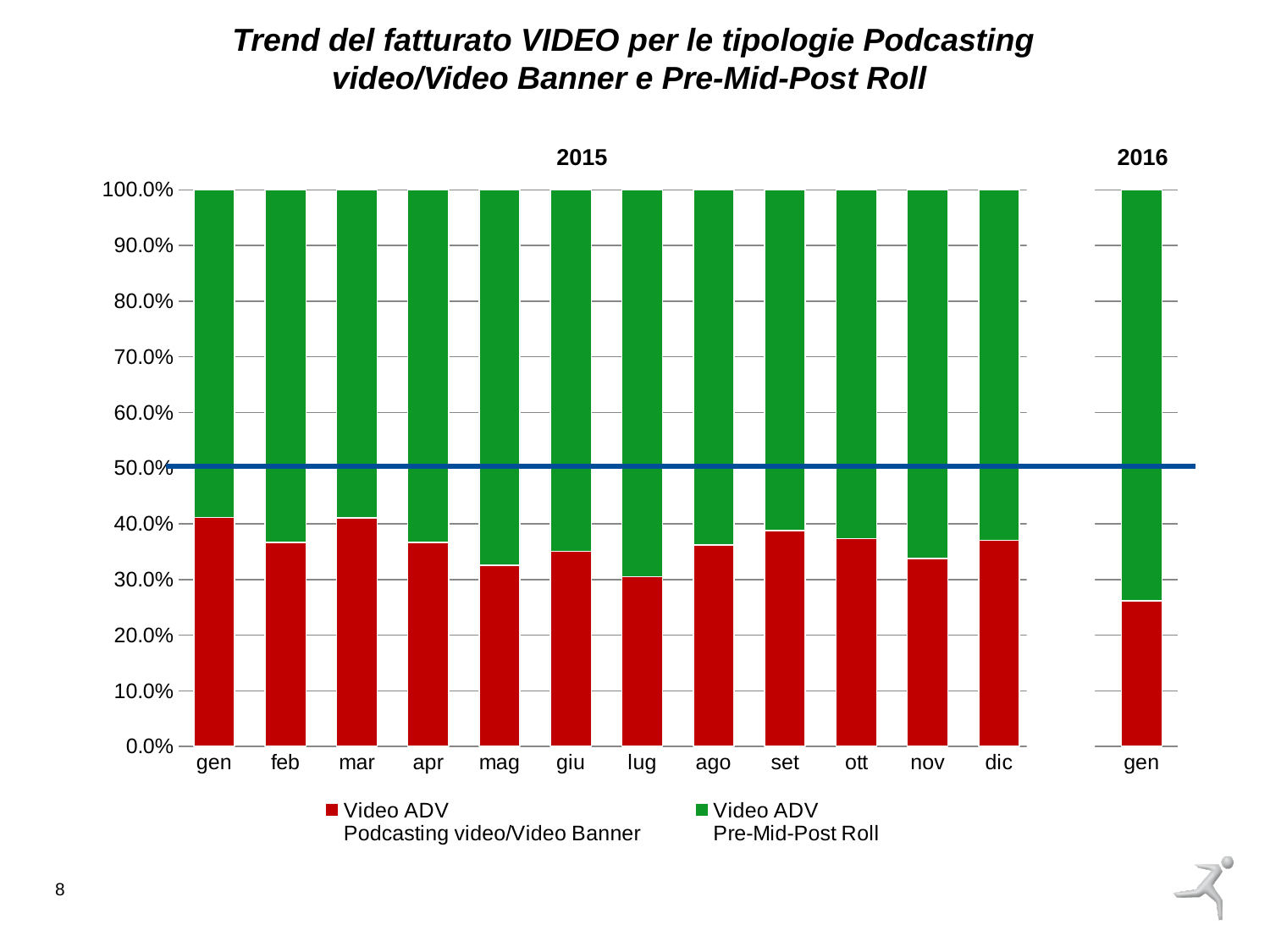
Which has the larger Video ADV Podcasting video/Video Banner share, gen 2015 or gen 2016? gen 2015 What kind of chart is shown on the slide? Stacked bar chart Is the Video ADV Pre-Mid-Post Roll share for gen 2016 greater or less than 70.0%? greater What is the total height of each stacked bar? 100.0% How many bars (months) are plotted in the chart? 13 Is the Video ADV Podcasting video/Video Banner share for lug 2015 greater or less than 40.0%? less Which month has the lowest share for Video ADV Podcasting video/Video Banner? gen (2016) Which has the larger Video ADV Podcasting video/Video Banner share, lug 2015 or set 2015? set 2015 Which colour represents Video ADV Pre-Mid-Post Roll in the chart? Green How many series does the legend list? 2 Which month has the highest share for Video ADV Pre-Mid-Post Roll? gen (2016) Is the Video ADV Podcasting video/Video Banner share for gen 2016 greater or less than 30.0%? less